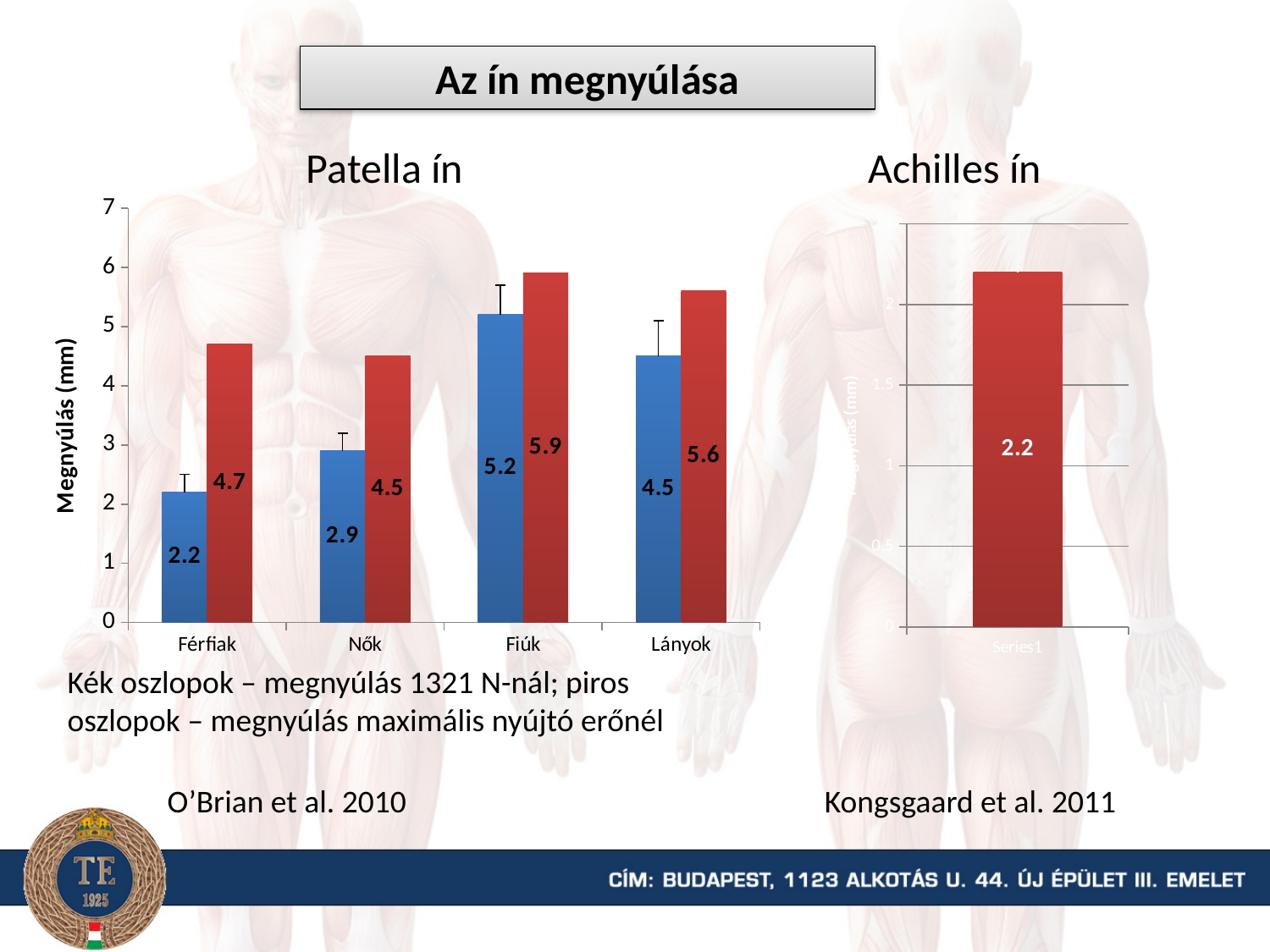
What type of chart is the Achilles ín chart? bar chart In the Patella ín chart, what is the value of the blue bar for Nők? 2.9 In the Patella ín chart, which category has the highest red bar? Fiúk In the Patella ín chart, is the red bar for Nők greater or less than 4? greater In the Patella ín chart, which is larger: the blue bar for Fiúk or the blue bar for Lányok? Fiúk In the Patella ín chart, what is the difference between the red and blue bars for Férfiak? 2.5 What is the y-axis label of the Patella ín chart? Megnyúlás (mm) In the Patella ín chart, what is the value of the blue bar for Férfiak? 2.2 In the Patella ín chart, what is the value of the red bar for Fiúk? 5.9 In the Patella ín chart, which category has the lowest blue bar? Férfiak How many categories are shown on the x axis of the Patella ín chart? 4 In the Achilles ín chart, what is the value shown on the bar? 2.2